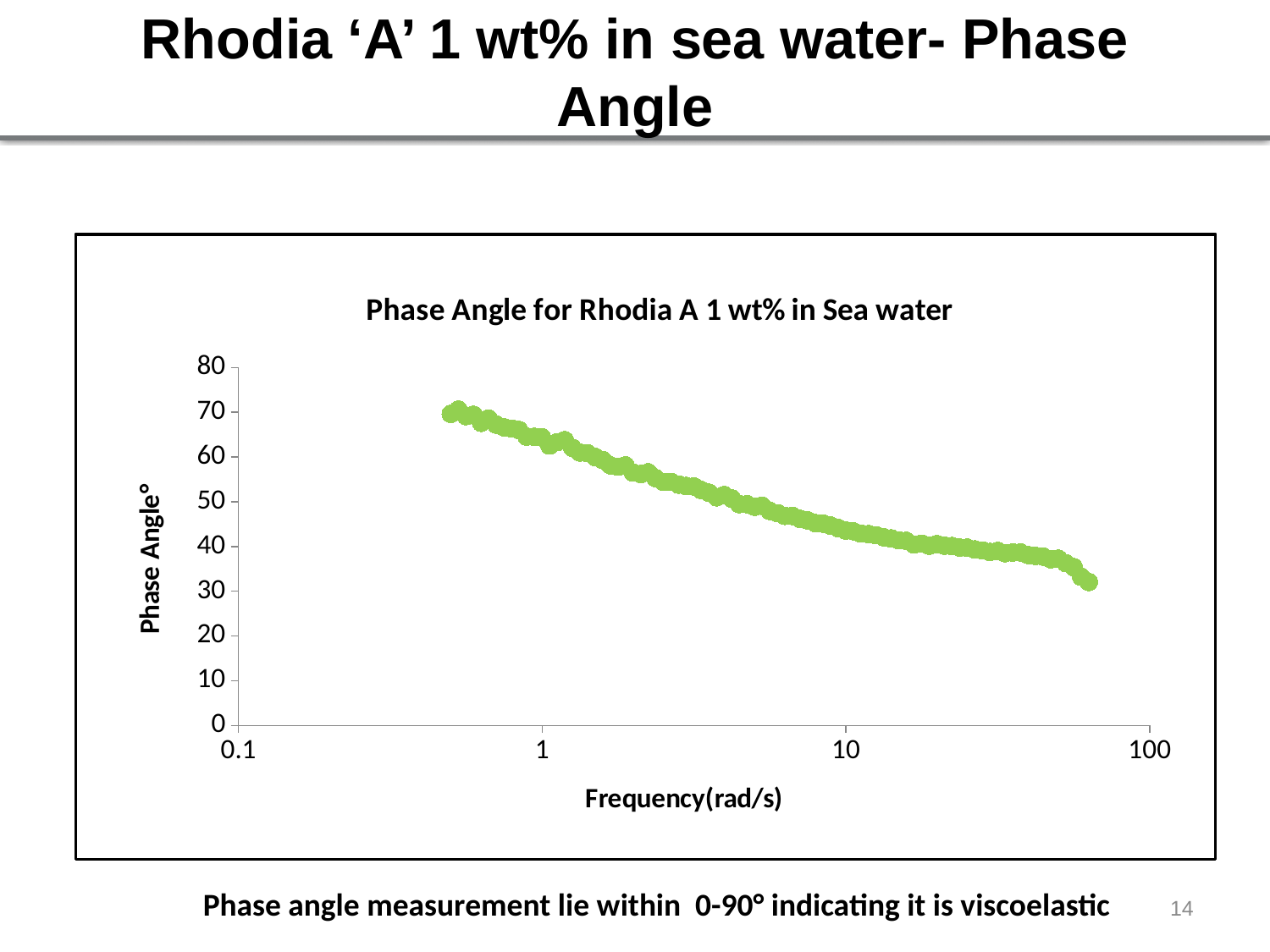
What is the label of the y axis? Phase Angle° Is the highest phase angle plotted greater or less than 80? less Is the phase angle at a frequency of 10 rad/s greater or less than 30? greater Is the phase angle higher at a frequency of 1 rad/s or at 10 rad/s? 1 rad/s What is the maximum value shown on the y axis? 80 Is the phase angle at a frequency of 1 rad/s greater or less than 50? greater What kind of chart is shown on the slide? scatter chart Does the phase angle rise or fall as frequency increases along the x axis? fall What is the title of the chart? Phase Angle for Rhodia A 1 wt% in Sea water